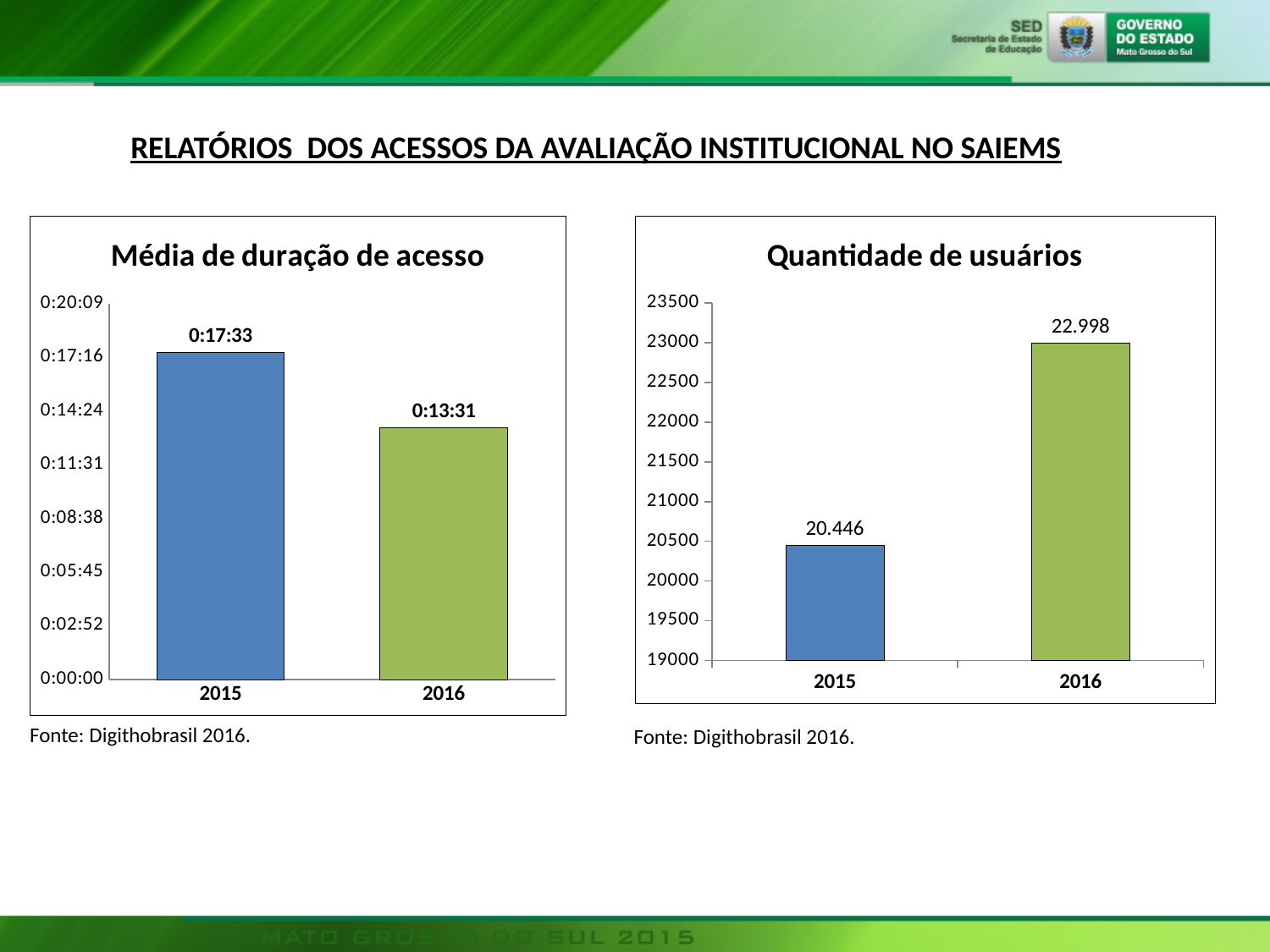
In the 'Média de duração de acesso' chart, which year has the lowest value? 2016 In the 'Média de duração de acesso' chart, is the value for 2015 larger or smaller than the value for 2016? larger In the 'Quantidade de usuários' chart, do the values rise or fall from 2015 to 2016? rise In the 'Quantidade de usuários' chart, which year has the highest value? 2016 What kind of chart is the 'Média de duração de acesso' chart? bar chart In the 'Quantidade de usuários' chart, what is the difference between the 2016 and 2015 values? 2.552 How many categories are shown on the x axis of the 'Quantidade de usuários' chart? 2 In the 'Média de duração de acesso' chart, what is the value for 2015? 0:17:33 In the 'Quantidade de usuários' chart, what is the value for 2016? 22.998 In the 'Média de duração de acesso' chart, what is the value for 2016? 0:13:31 In the 'Quantidade de usuários' chart, what is the value for 2015? 20.446 In the 'Quantidade de usuários' chart, is the value for 2015 greater or less than 21000? less